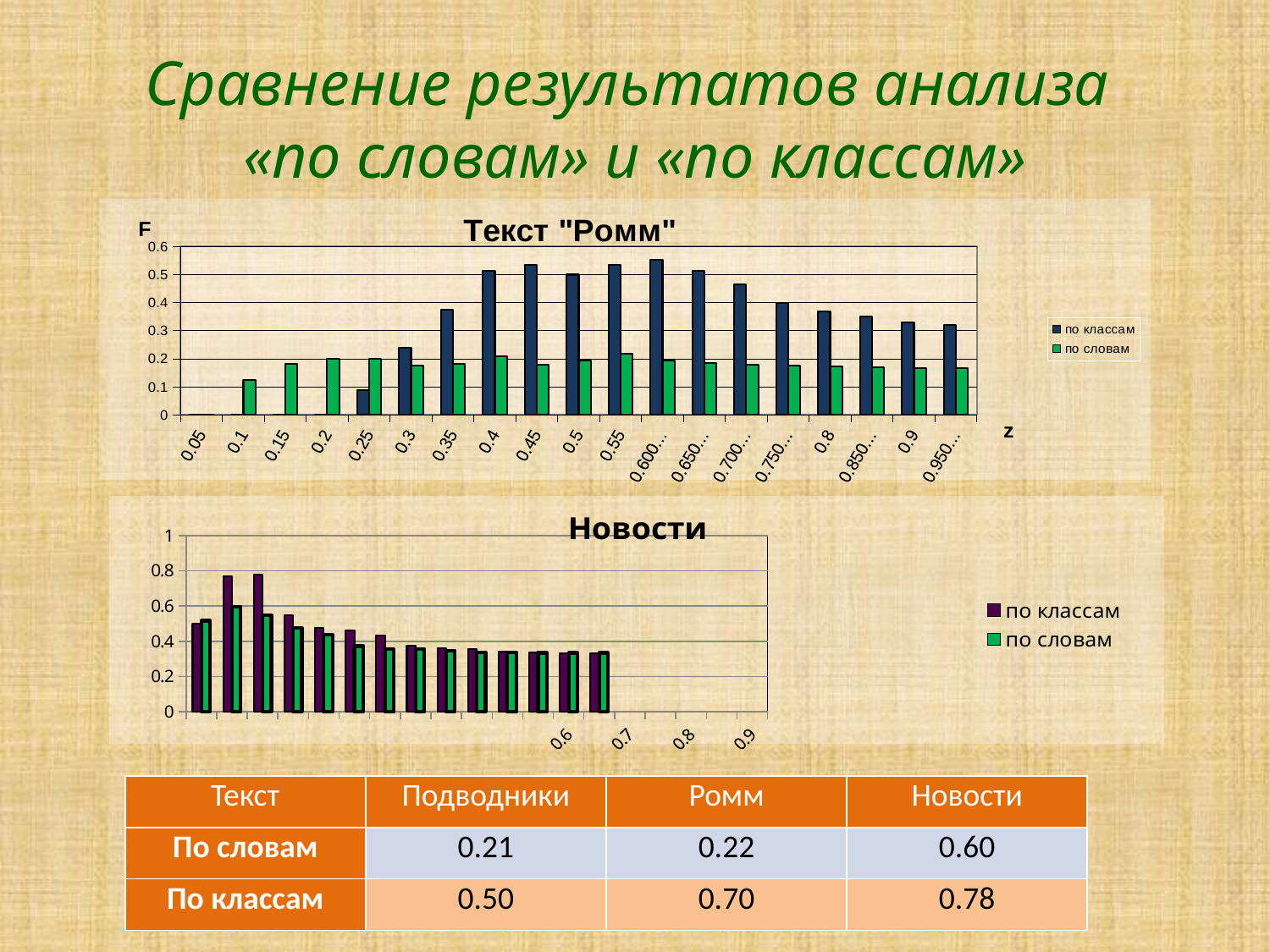
What are the two legend entries in the "Новости" chart? по классам, по словам How many series does the legend of the "Текст "Ромм"" chart list? 2 What kind of chart is the "Текст "Ромм"" chart? bar chart In the "Текст "Ромм"" chart, is the value of "по словам" at 0.1 greater or less than 0.2? less How many categories are shown on the x axis of the "Текст "Ромм"" chart? 19 In the "Текст "Ромм"" chart, is the value of "по классам" at 0.8 greater or less than 0.3? greater In the "Текст "Ромм"" chart, which series has the larger value at 0.5: "по классам" or "по словам"? по классам What label is shown on the vertical axis of the "Текст "Ромм"" chart? F In the "Текст "Ромм"" chart, is the value of "по классам" at 0.25 greater or less than 0.2? less In the "Текст "Ромм"" chart, which series has the larger value at 0.2: "по классам" or "по словам"? по словам What kind of chart is the "Новости" chart? bar chart